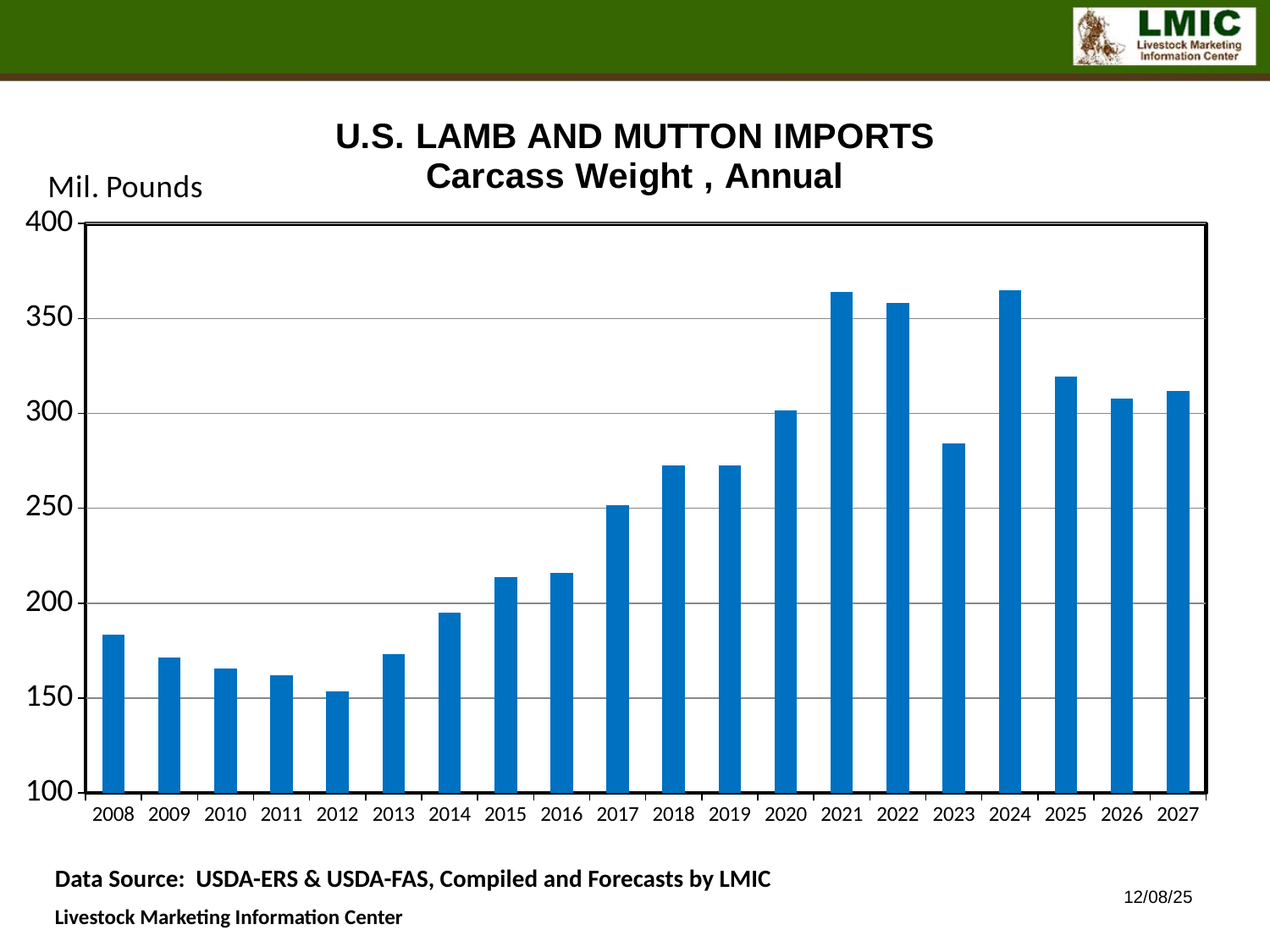
Is the value for 2023 greater or less than 300? less Is the value for 2018 greater or less than 250? greater Which year has the larger value, 2022 or 2023? 2022 Which year has the lowest value for U.S. lamb and mutton imports? 2012 What kind of chart is shown on the slide? Bar chart Do the values rise or fall from 2008 to 2012? fall Is the value for 2025 greater or less than 300? greater How many years are plotted on the x axis? 20 Which year has the larger value, 2008 or 2012? 2008 What unit is shown on the y axis label? Mil. Pounds